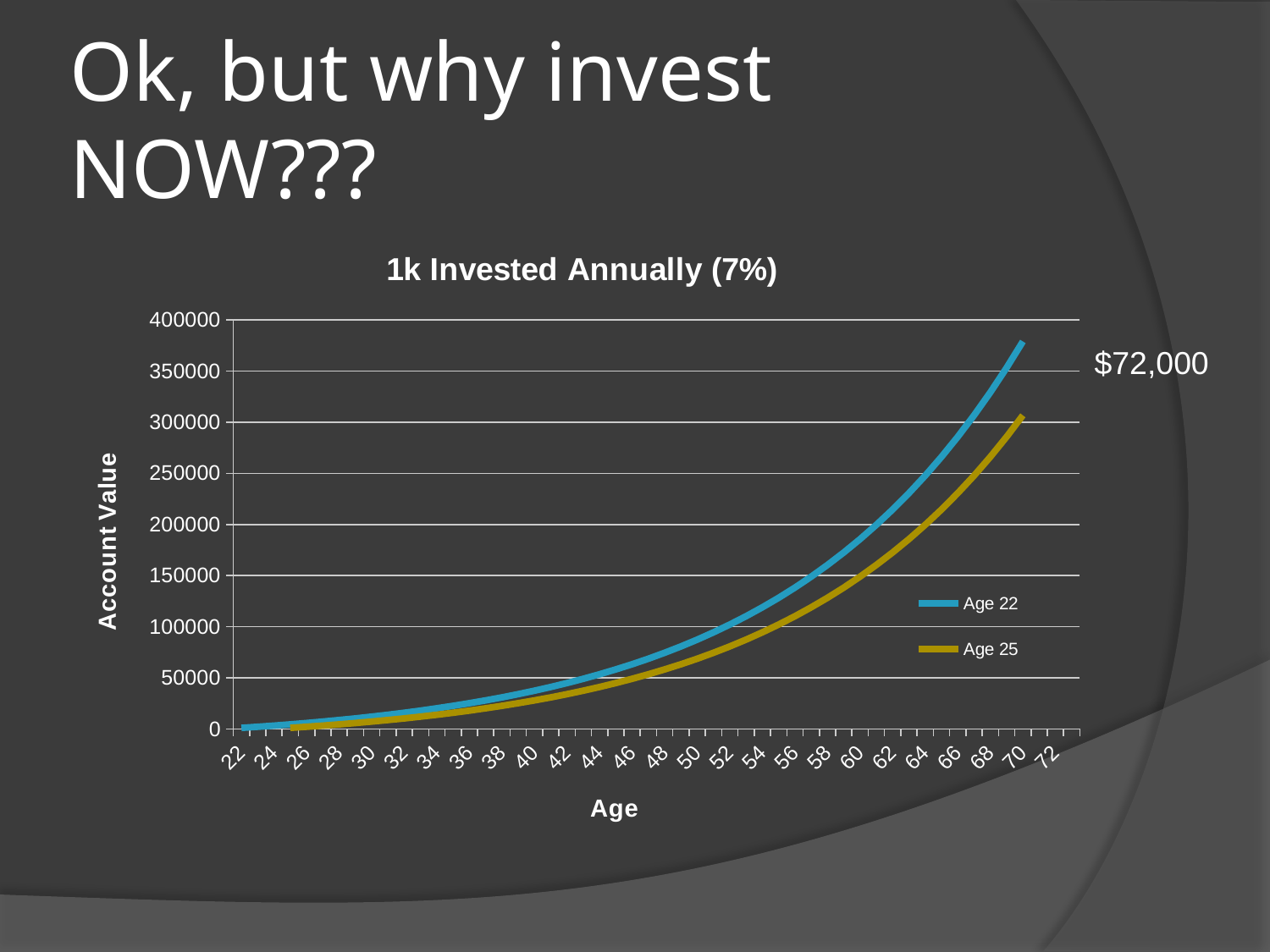
What is the label on the vertical axis of the chart? Account Value Do the account values rise or fall as age increases along the x axis? rise Is the value for the Age 22 series at age 64 greater or less than 200000? greater What are the two series named in the legend? Age 22 and Age 25 At age 70, which series has the higher account value, Age 22 or Age 25? Age 22 What kind of chart is shown on the slide? line chart How many series does the legend list? 2 What is the title of the chart? 1k Invested Annually (7%) Is the value for the Age 22 series at age 40 greater or less than 50000? less Is the value for the Age 22 series at age 70 greater or less than 350000? greater